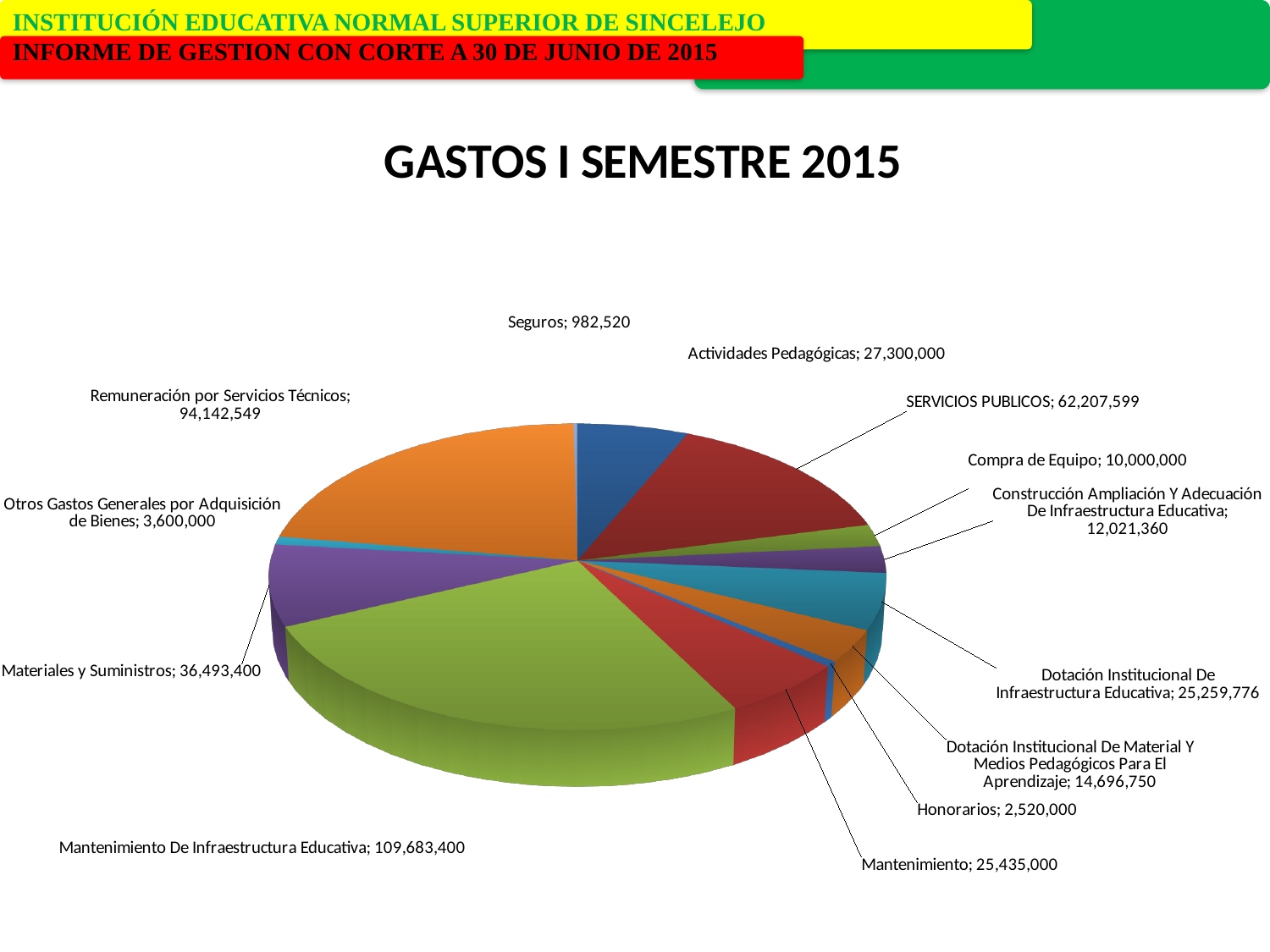
What is the difference between Mantenimiento De Infraestructura Educativa and Remuneración por Servicios Técnicos? 15,540,851 What is the value for Honorarios? 2,520,000 What is the value for SERVICIOS PUBLICOS? 62,207,599 Which category has the largest value? Mantenimiento De Infraestructura Educativa Which category has the smallest value? Seguros What is the value for Mantenimiento De Infraestructura Educativa? 109,683,400 How many categories are shown in the pie chart? 13 Which is larger, Materiales y Suministros or Actividades Pedagógicas? Materiales y Suministros What kind of chart is shown on the slide? Pie chart What is the difference between Compra de Equipo and Honorarios? 7,480,000 What is the value for Dotación Institucional De Material Y Medios Pedagógicos Para El Aprendizaje? 14,696,750 What is the title of the chart? GASTOS I SEMESTRE 2015